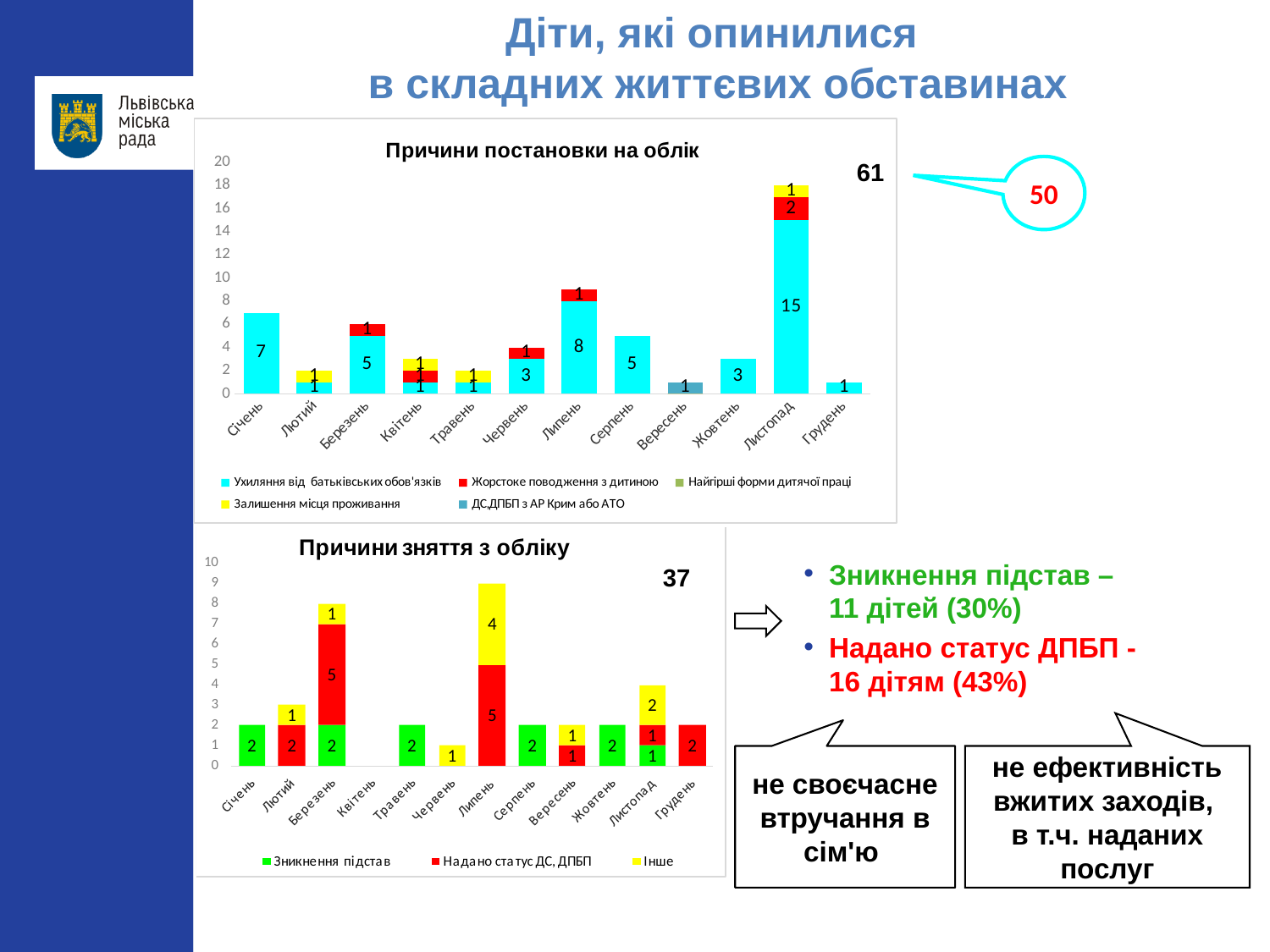
In the chart 'Причини постановки на облік', which month has the tallest stacked bar? Листопад What type of chart is 'Причини зняття з обліку'? Stacked bar chart In the chart 'Причини постановки на облік', how many series does the legend list? 5 In the chart 'Причини постановки на облік', what is the value of 'Ухиляння від батьківських обов'язків' for Листопад? 15 In the chart 'Причини постановки на облік', what is the value of 'Ухиляння від батьківських обов'язків' for Січень? 7 In the chart 'Причини зняття з обліку', what is the total of the stacked bar for Березень? 8 In the chart 'Причини постановки на облік', what is the difference between the 'Ухиляння від батьківських обов'язків' values for Липень and Червень? 5 In the chart 'Причини зняття з обліку', what is the value of 'Інше' for Липень? 4 In the chart 'Причини зняття з обліку', what is the value of 'Надано статус ДС, ДПБП' for Березень? 5 In the chart 'Причини постановки на облік', what is the total of the stacked bar for Листопад? 18 In the chart 'Причини зняття з обліку', how many series does the legend list? 3 In the chart 'Причини зняття з обліку', which month has the tallest stacked bar? Липень